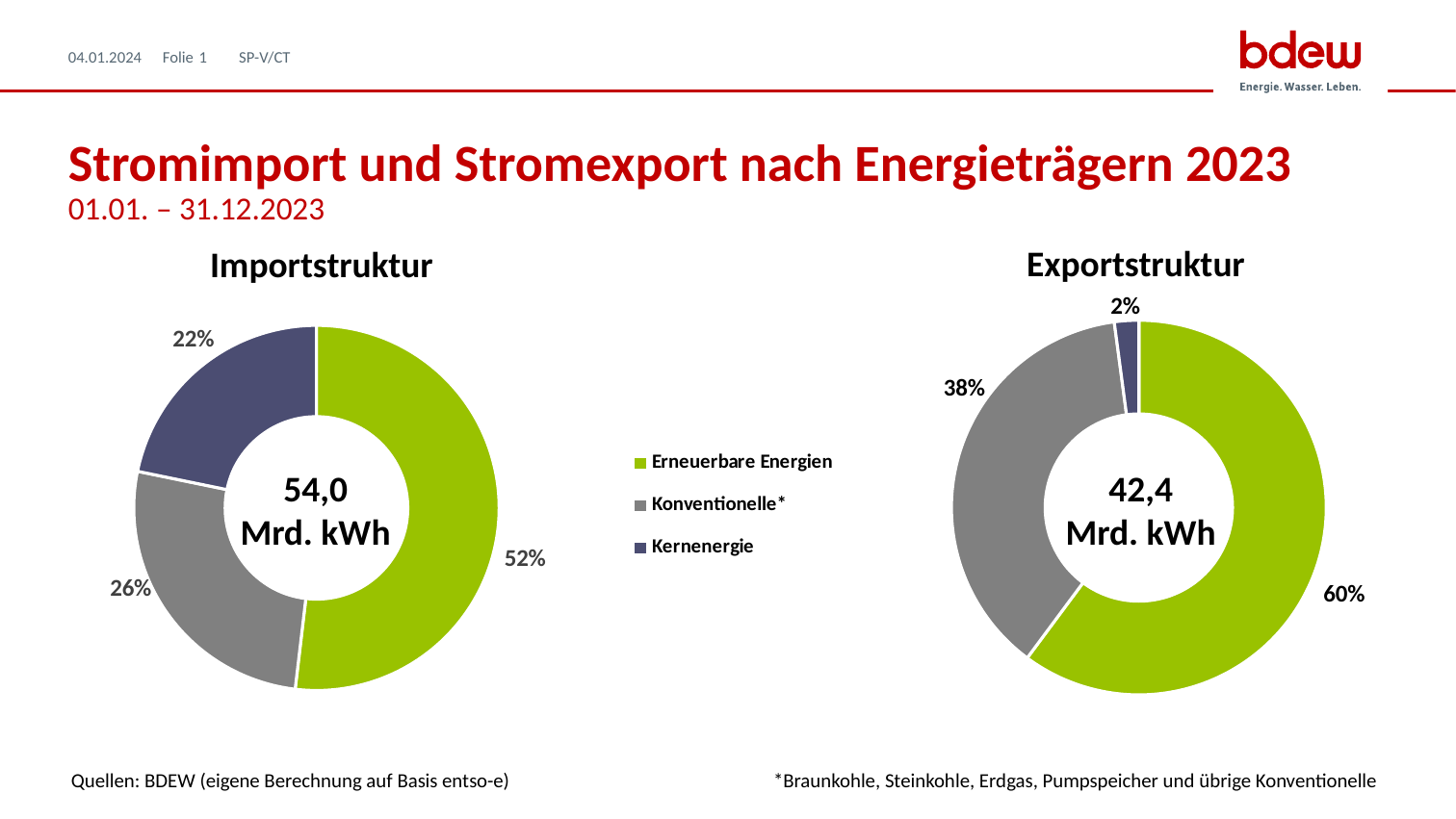
In the Importstruktur chart, which energy source has the smallest share? Kernenergie What total volume is shown in the centre of the Exportstruktur chart? 42,4 Mrd. kWh How many categories does the legend list for the charts? 3 In the Exportstruktur chart, which energy source has the largest share? Erneuerbare Energien In the Importstruktur chart, what share does Erneuerbare Energien have? 52% Is the Konventionelle* share larger in the Importstruktur chart or in the Exportstruktur chart? Exportstruktur In the Importstruktur chart, what share does Kernenergie have? 22% What total volume is shown in the centre of the Importstruktur chart? 54,0 Mrd. kWh In the Exportstruktur chart, what share does Konventionelle* have? 38% What type of chart is the Importstruktur chart? Donut (pie) chart In the Exportstruktur chart, what share does Kernenergie have? 2% What is the difference between the Erneuerbare Energien share in the Exportstruktur chart and in the Importstruktur chart? 8 percentage points